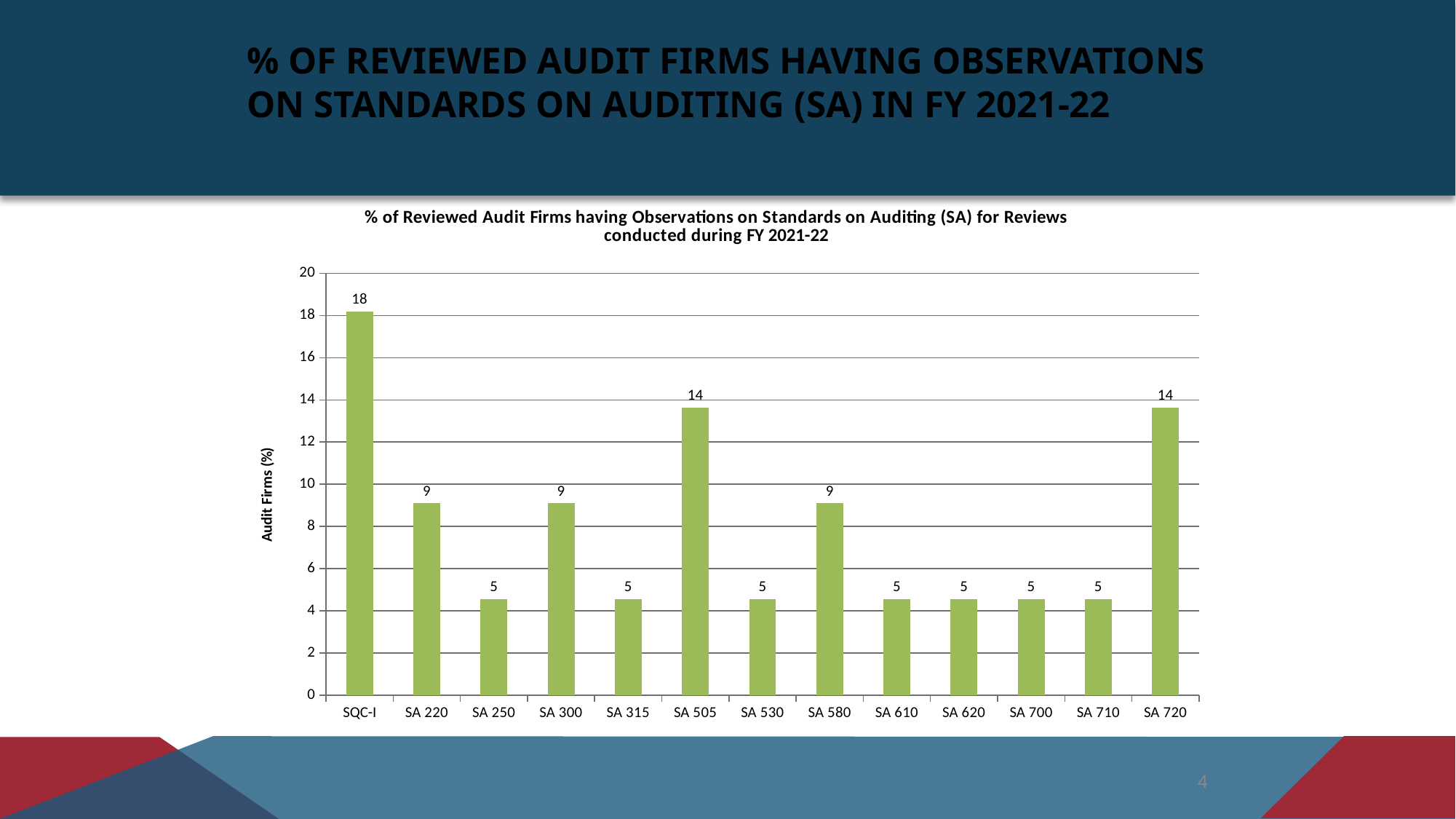
Is the value for SA 720 greater or less than 10? greater Which is larger, the value for SA 505 or the value for SA 220? SA 505 What type of chart is shown on the slide? bar chart What is the difference between the values for SQC-I and SA 720? 4 Which category has the highest value? SQC-I What is the value for SQC-I? 18 How many categories are shown on the x axis? 13 What is the difference between the values for SA 300 and SA 315? 4 What is the value for SA 505? 14 What is the title of the vertical axis? Audit Firms (%) What is the value for SA 700? 5 What is the value for SA 580? 9